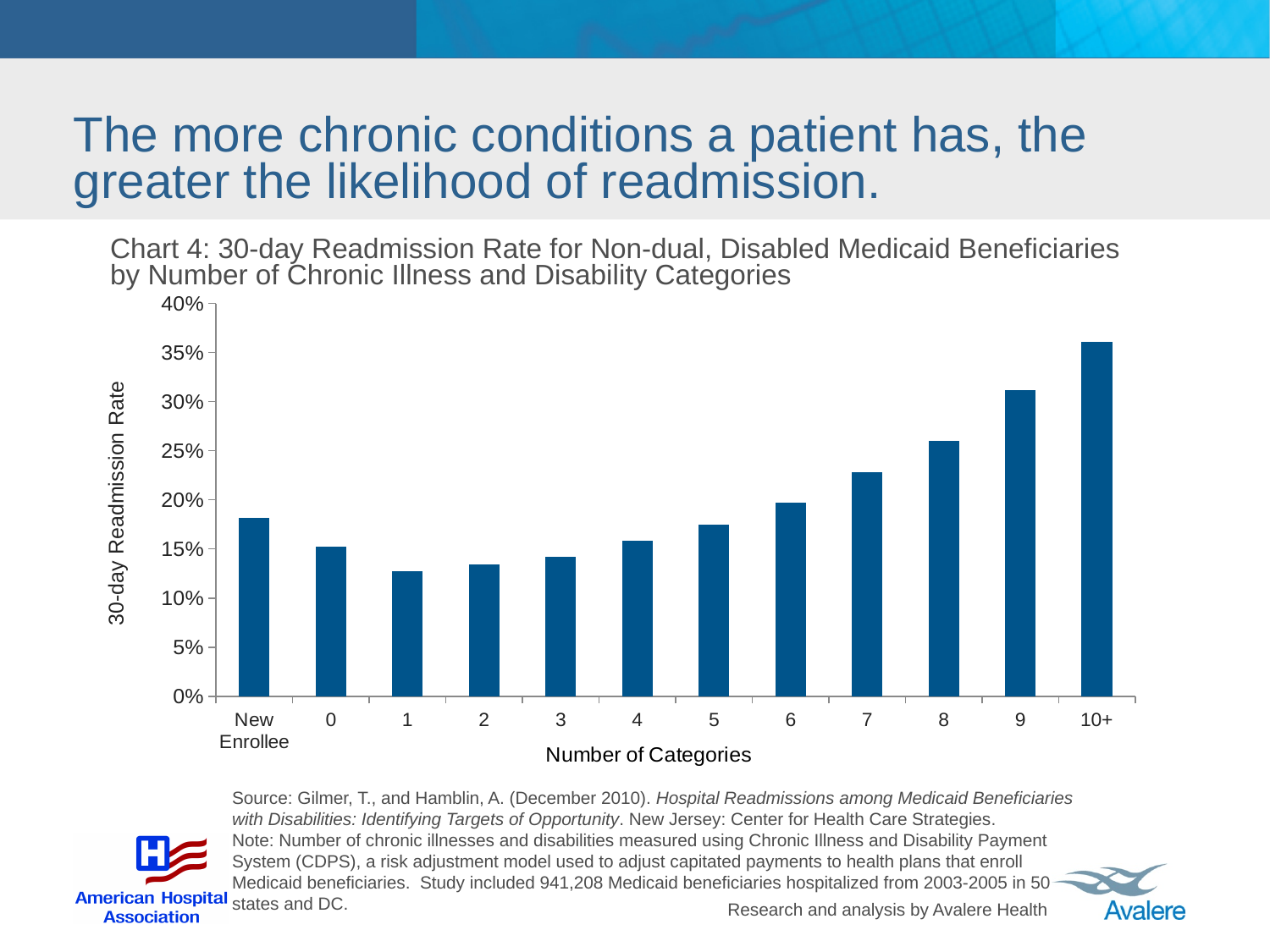
Which category has the highest 30-day readmission rate? 10+ Which category has the lowest 30-day readmission rate? 1 Is the 30-day readmission rate for the 9 category greater or less than 25%? greater What kind of chart is shown on the slide? bar chart Is the 30-day readmission rate for the 7 category greater or less than 20%? greater Is the 30-day readmission rate for the 1 category greater or less than 15%? less From the 1 category through the 10+ category, does the 30-day readmission rate rise or fall? rise Which has a higher 30-day readmission rate, New Enrollee or the 0 category? New Enrollee How many categories are shown along the x axis of the chart? 12 What is the label of the y axis of the chart? 30-day Readmission Rate